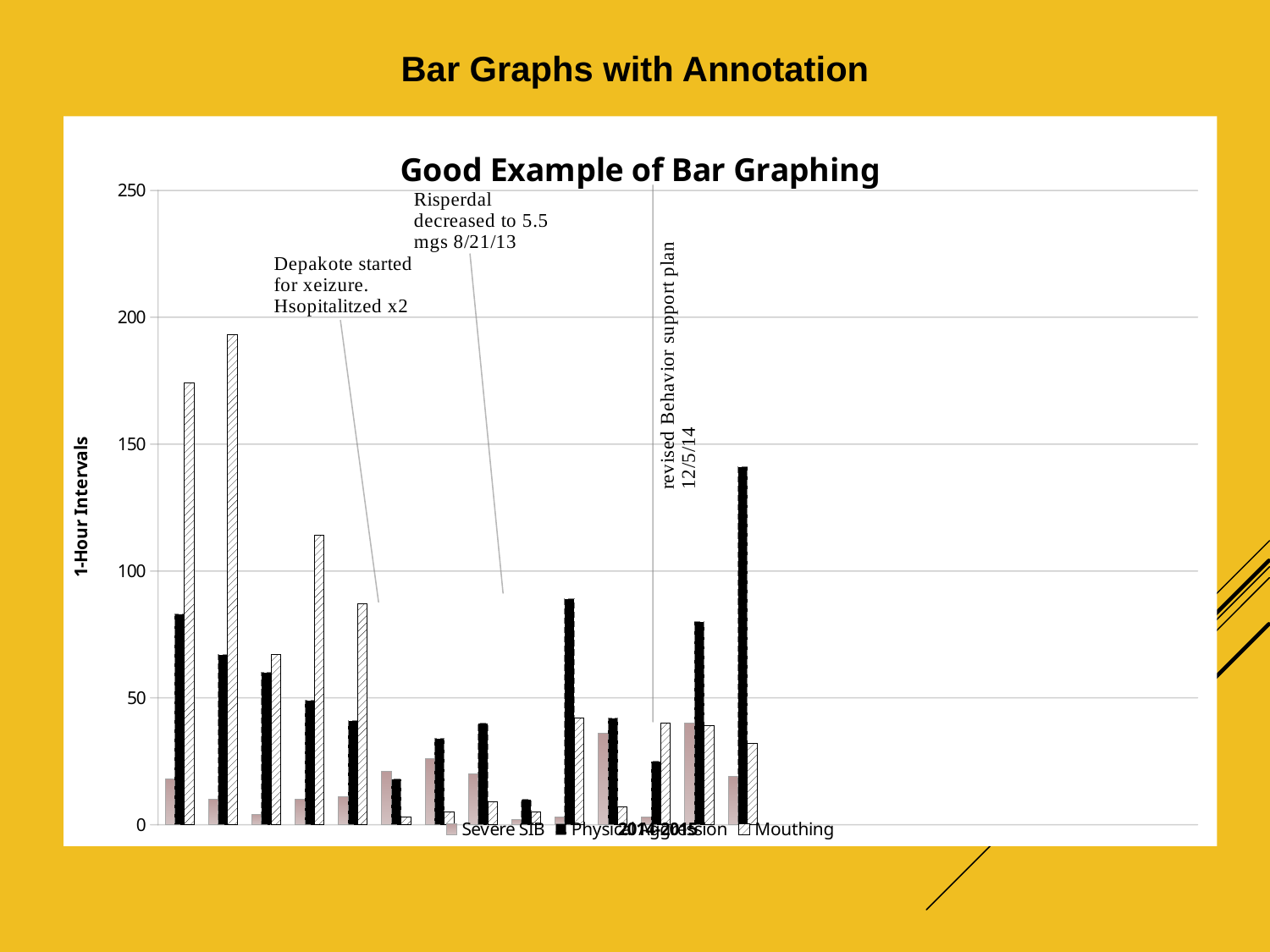
What is the title of the y axis? 1-Hour Intervals How many series does the legend list? 3 Is the tallest Physical Aggression bar greater or less than 100? greater Is the tallest Mouthing bar greater or less than 150? greater Which series has the tallest bar anywhere on the chart? Mouthing What kind of chart is shown on the slide? bar chart Is the tallest Severe SIB bar greater or less than 50? less Do the Mouthing bars generally rise or fall from left to right across the chart? fall In the rightmost group of bars, which is larger: Physical Aggression or Mouthing? Physical Aggression What are the three series named in the legend? Severe SIB, Physical Aggression, Mouthing In the leftmost group of bars, which is larger: Mouthing or Physical Aggression? Mouthing